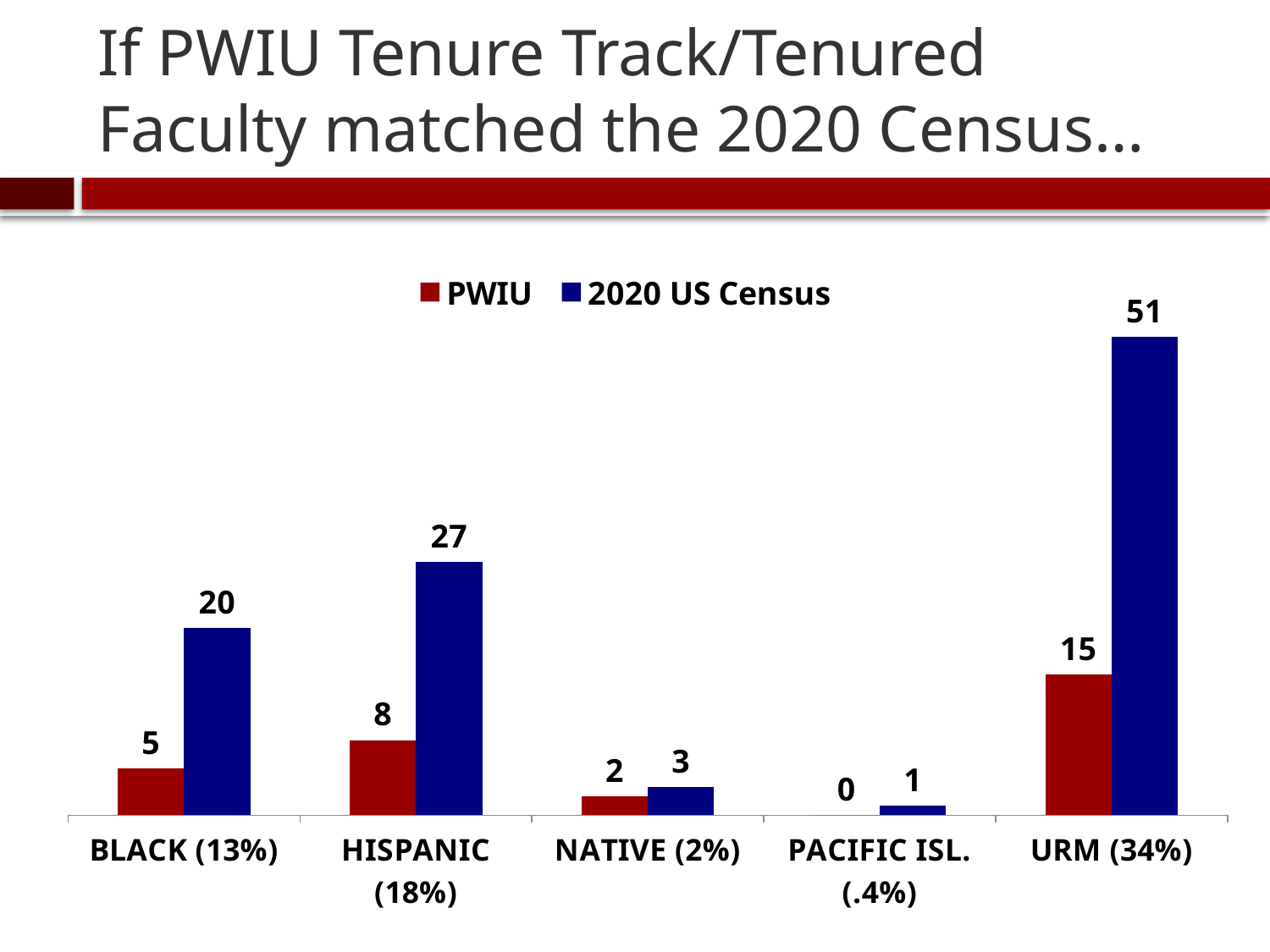
Which category has the highest 2020 US Census value? URM (34%) How many series does the legend list? 2 What is the PWIU value for PACIFIC ISL. (.4%)? 0 What is the difference between the 2020 US Census value and the PWIU value for URM (34%)? 36 How many categories are shown on the x axis? 5 What kind of chart is shown on the slide? Bar chart What is the 2020 US Census value for HISPANIC (18%)? 27 Which is larger for NATIVE (2%): the PWIU value or the 2020 US Census value? 2020 US Census Which category has the lowest PWIU value? PACIFIC ISL. (.4%) What is the PWIU value for BLACK (13%)? 5 What is the difference between the 2020 US Census value and the PWIU value for BLACK (13%)? 15 What is the 2020 US Census value for URM (34%)? 51